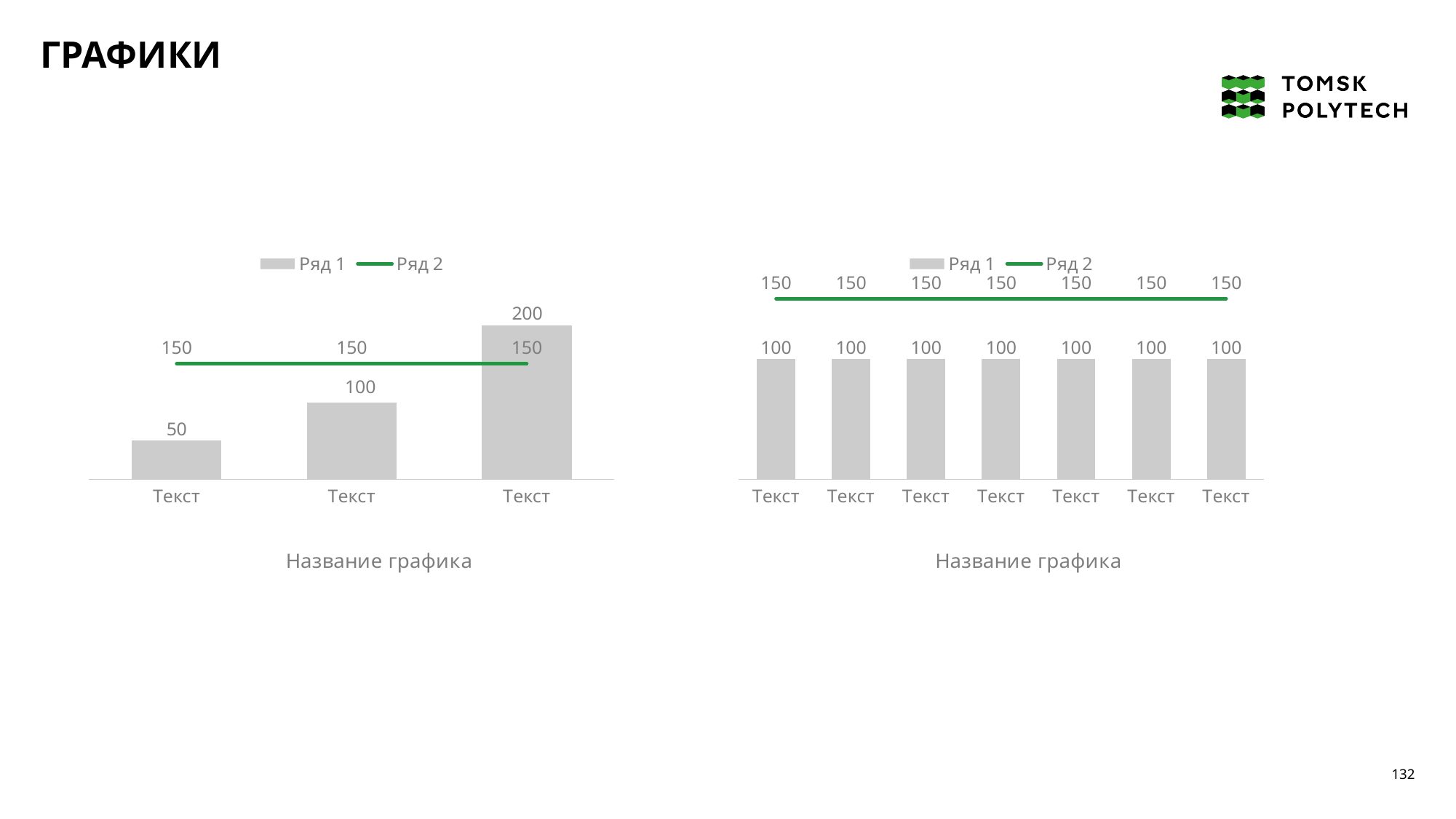
In the left chart, do the Ряд 1 values rise or fall from left to right? Rise In the right chart, how many categories are shown on the x axis? 7 In the left chart, what is the value of Ряд 1 for the first category? 50 In the left chart, which category has the highest Ряд 1 value? The third category In the left chart, what is the value of Ряд 2 for the second category? 150 In the left chart, what is the value of Ряд 1 for the third category? 200 In the right chart, which is larger for the first category, Ряд 1 or Ряд 2? Ряд 2 In the right chart, what is the value of Ряд 1 for the fourth category? 100 In the right chart, what colour is the Ряд 2 line? Green In the left chart, how many series does the legend list? 2 In the left chart, which category has the lowest Ряд 1 value? The first category In the left chart, what is the difference between the Ряд 1 values of the third and first categories? 150